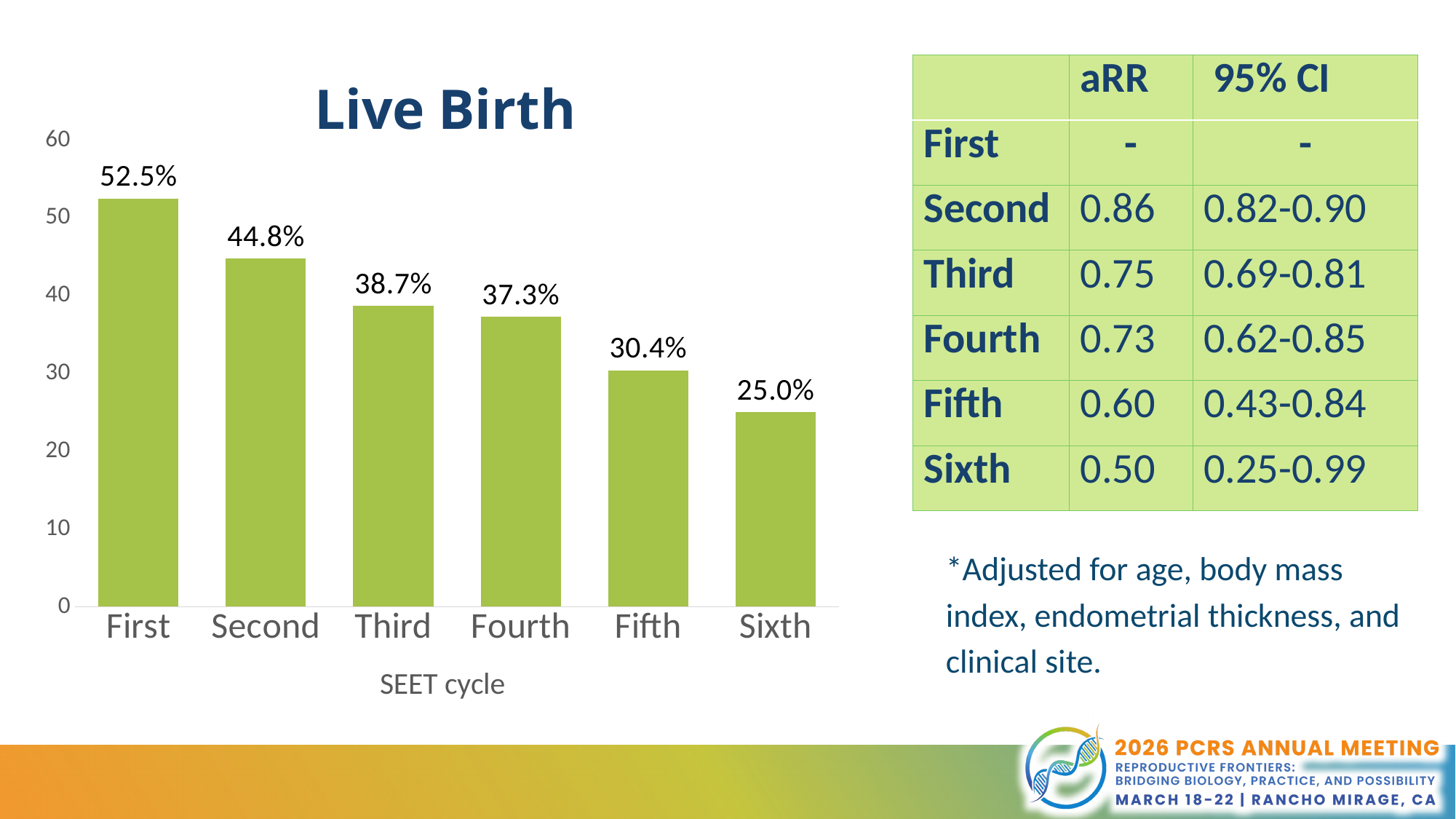
What is the difference in live birth rate between the Fifth and Sixth SEET cycles? 5.4% Is the live birth rate for the Second SEET cycle greater or less than 40? greater What is the live birth rate for the First SEET cycle? 52.5% Which SEET cycle has the lowest live birth rate? Sixth What is the live birth rate for the Sixth SEET cycle? 25.0% What kind of chart is used to show live birth rates? Bar chart Which has a higher live birth rate, the Third or the Fifth SEET cycle? Third How many SEET cycle categories are shown in the chart? 6 What is the difference in live birth rate between the First and Second SEET cycles? 7.7% Which SEET cycle has the highest live birth rate? First Do live birth rates rise or fall from the First to the Sixth SEET cycle? Fall What is the live birth rate for the Fourth SEET cycle? 37.3%